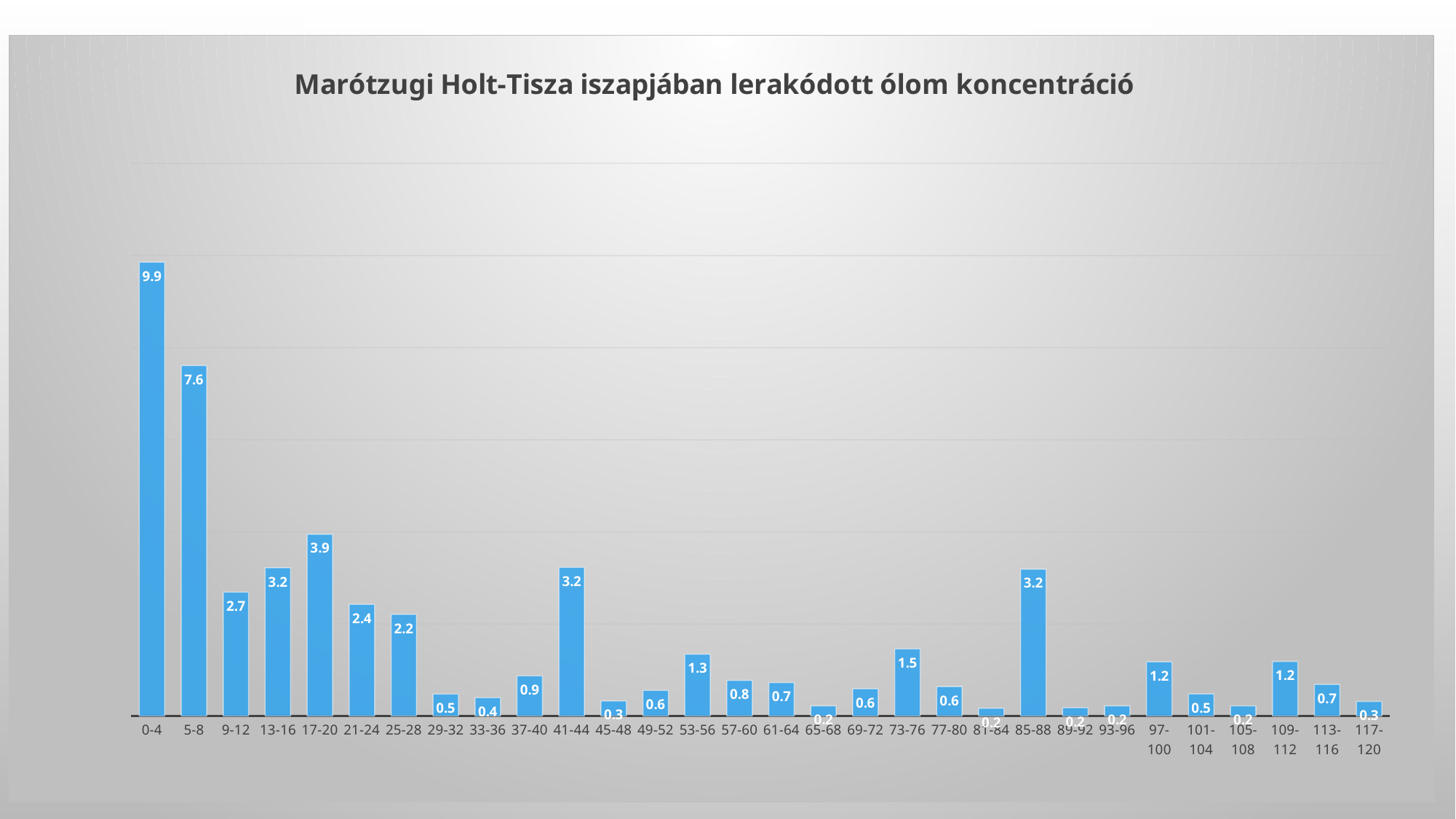
What is the value for the 73-76 category? 1.5 What is the value for the 109-112 category? 1.2 What is the value for the 0-4 category? 9.9 What is the difference between the values for 0-4 and 5-8? 2.3 What kind of chart is this? bar chart Which category has the highest value? 0-4 What is the lowest value shown on the chart? 0.2 What is the value for the 85-88 category? 3.2 Which has a larger value, 17-20 or 13-16? 17-20 How many categories are shown on the x axis? 30 What is the difference between the values for 17-20 and 9-12? 1.2 What is the title of the chart? Marótzugi Holt-Tisza iszapjában lerakódott ólom koncentráció